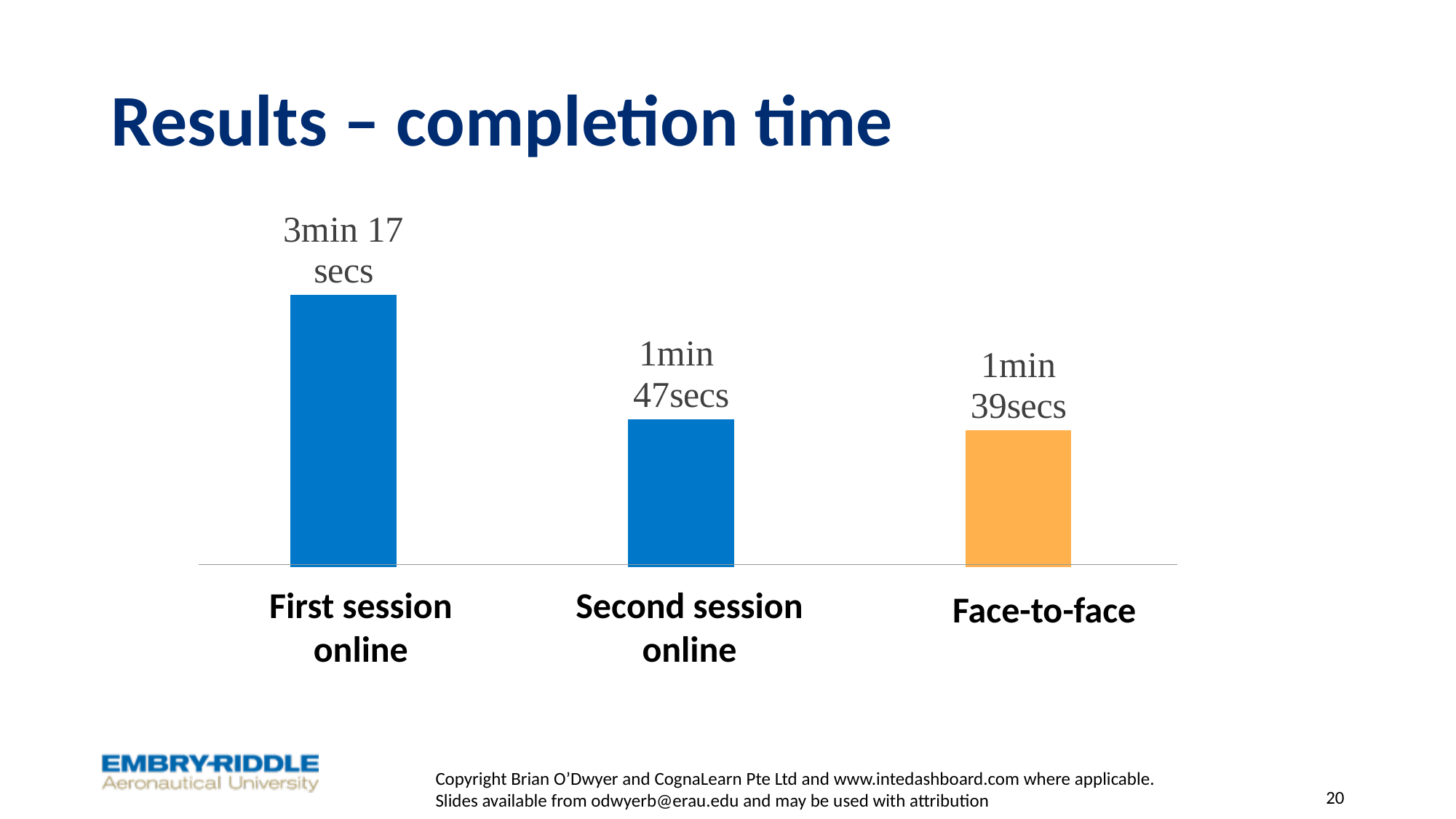
What is the completion time for Face-to-face? 1min 39secs Which category has the shortest completion time? Face-to-face What is the difference in completion time between the Second session online and Face-to-face? 8 secs Which category has the longest completion time? First session online What is the completion time for the First session online? 3min 17 secs What type of chart is shown on the slide? Bar chart Which bar is coloured orange rather than blue? Face-to-face Which has a longer completion time, Second session online or Face-to-face? Second session online What is the completion time for the Second session online? 1min 47secs Do the completion times rise or fall from left to right across the chart? Fall How much longer is the First session online completion time than the Second session online? 1min 30secs How many categories are shown in the chart? 3